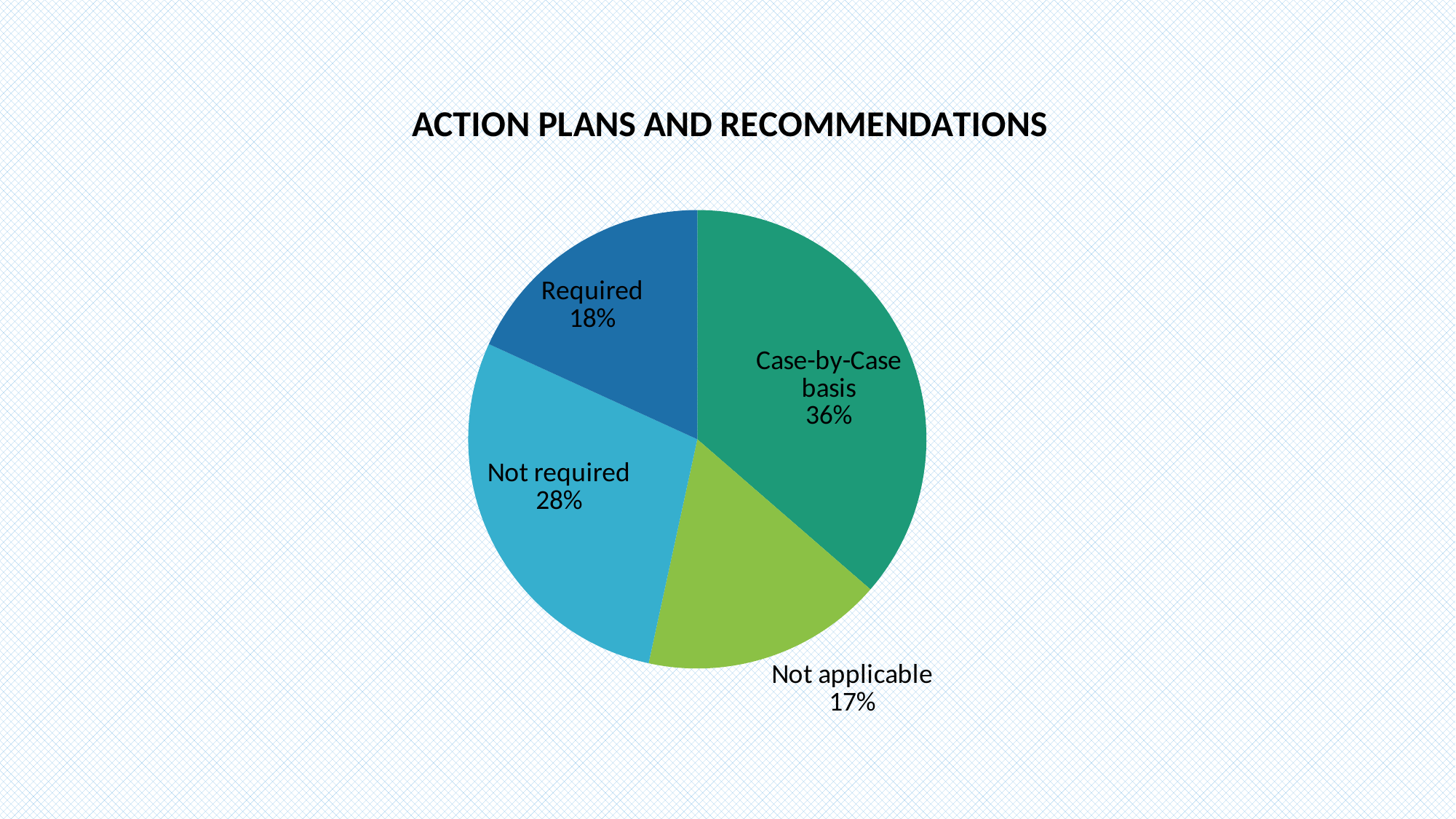
What percentage is shown for the Case-by-Case basis slice? 36% How many slices does the pie chart have? 4 What colour is the Not applicable slice? Green Which category has the smallest share of the pie? Not applicable What is the difference in percentage points between Case-by-Case basis and Not required? 8 Which is larger, the Not required slice or the Required slice? Not required What is the title of the chart? ACTION PLANS AND RECOMMENDATIONS What percentage is shown for the Not applicable slice? 17% What percentage is shown for the Not required slice? 28% What type of chart is shown on the slide? Pie chart What percentage is shown for the Required slice? 18% Which category has the largest share of the pie? Case-by-Case basis